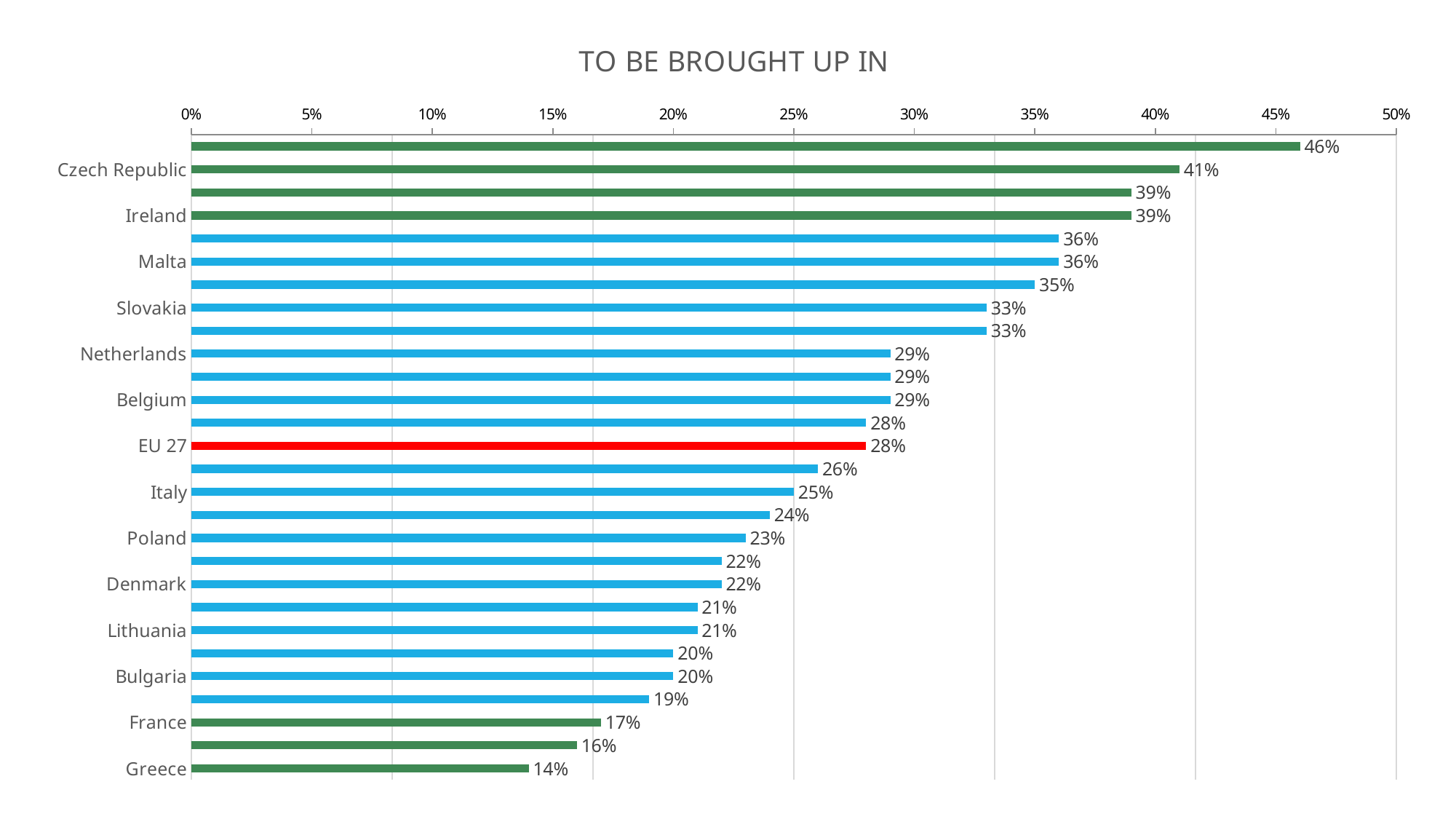
Which has a larger value, Denmark or Lithuania? Denmark What is the value for EU 27? 28% What is the difference between the values for Czech Republic and Greece? 27% What is the difference between the values for Ireland and Italy? 14% How many bars are plotted in the chart? 28 What colour is the bar for EU 27? red What kind of chart is shown on the slide? bar chart What is the value for Greece? 14% What is the value for Czech Republic? 41% Which labelled category has the lowest value? Greece What is the value for Ireland? 39% Which has a larger value, Malta or Slovakia? Malta